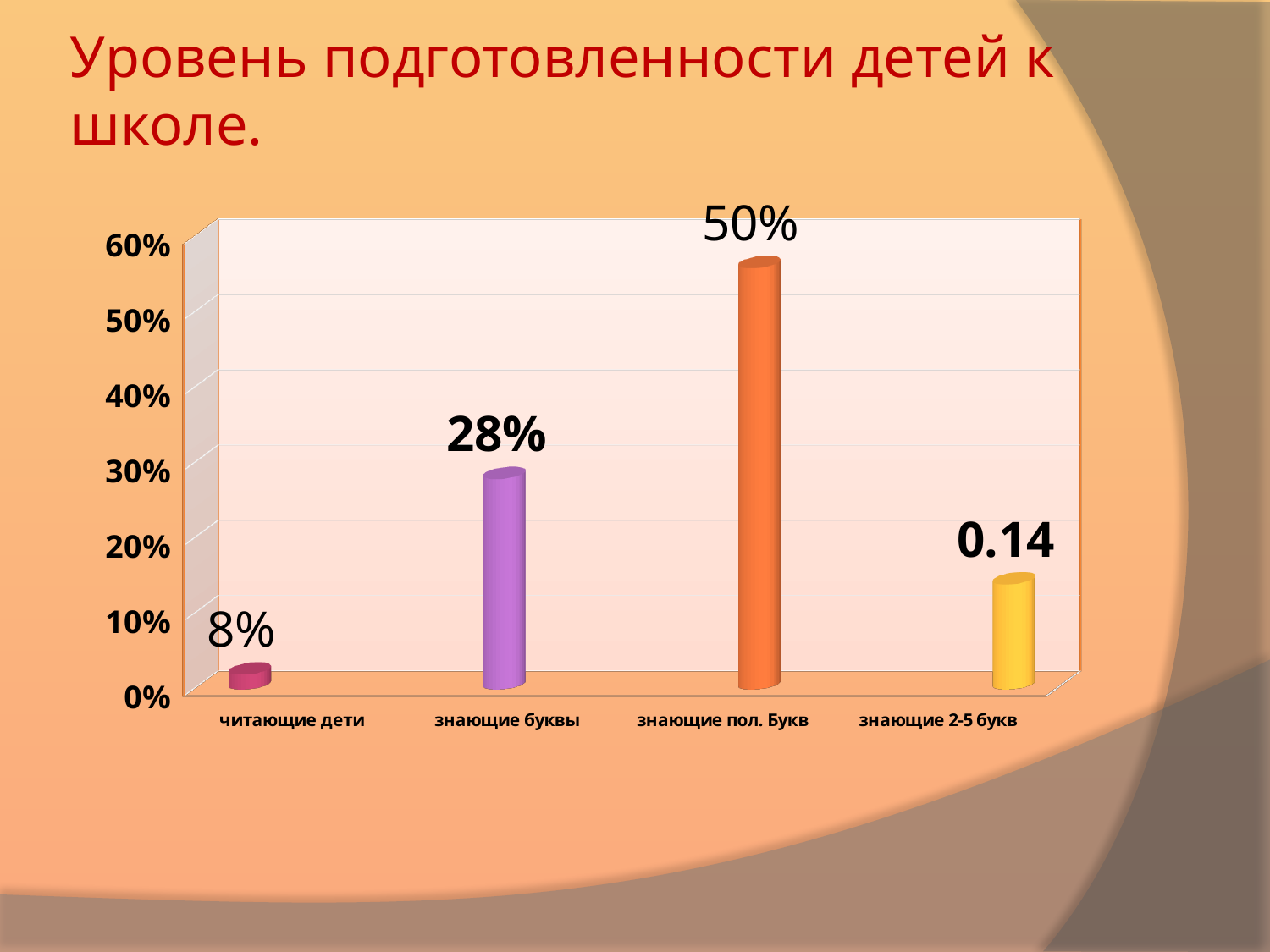
Which category has the highest value? знающие пол. Букв What is the value for знающие буквы? 28% Which category has the lowest value? читающие дети Which is larger, the value for знающие буквы or the value for знающие 2-5 букв? знающие буквы How many categories are shown on the x axis? 4 What data label is shown for знающие 2-5 букв? 0.14 What kind of chart is shown on the slide? bar chart What is the title of the slide? Уровень подготовленности детей к школе.